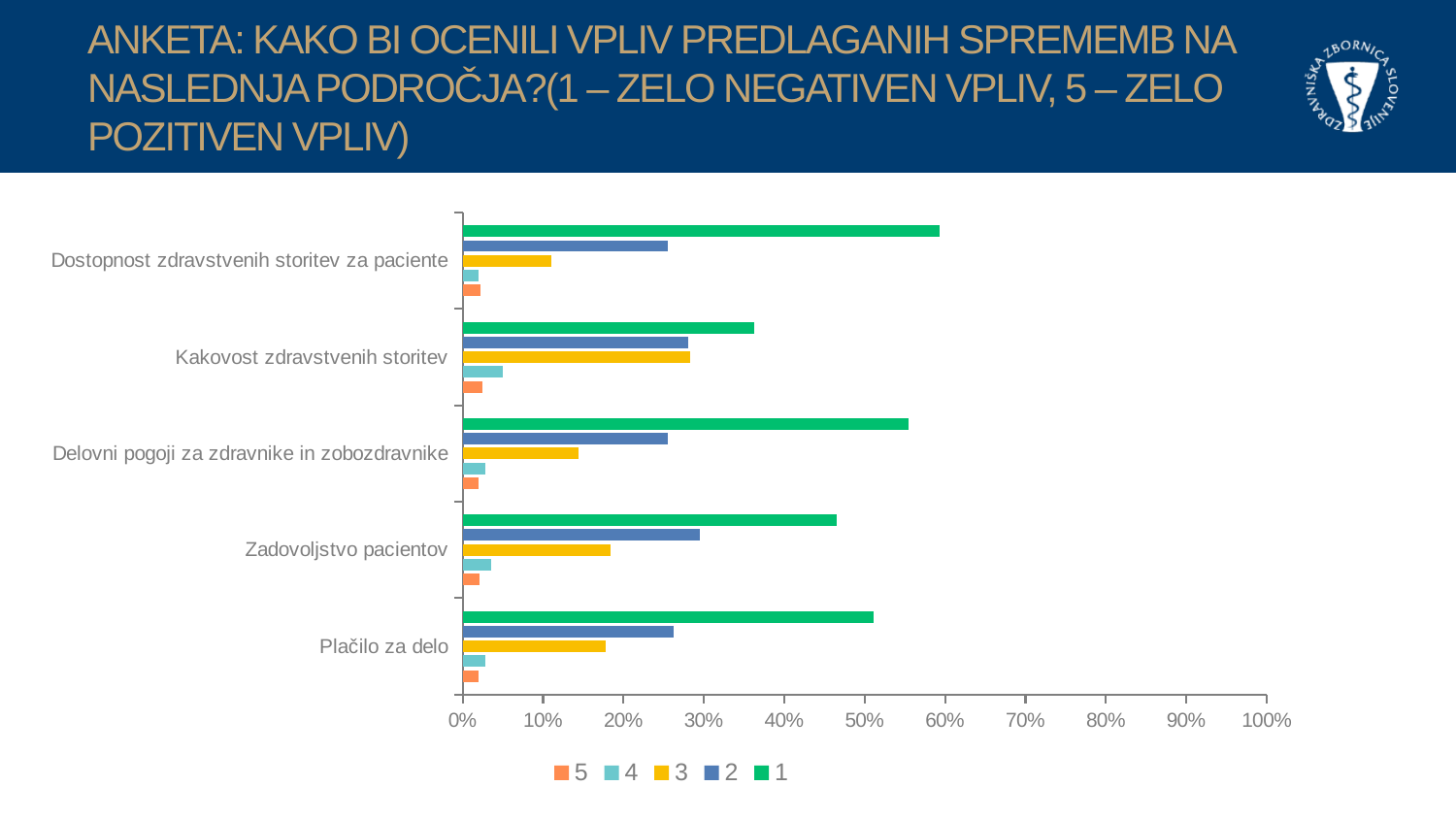
How many series does the chart legend list? 5 Which category has the shortest bar for series 1? Kakovost zdravstvenih storitev How many categories (areas) are listed on the vertical axis of the chart? 5 Which series is shown in orange in the chart legend? 5 What kind of chart is shown on the slide? bar chart Is the value of series 1 for Kakovost zdravstvenih storitev greater or less than 40%? less Which series is shown in green in the chart legend? 1 Which category has the longest bar for series 1? Dostopnost zdravstvenih storitev za paciente Is the value of series 1 for Dostopnost zdravstvenih storitev za paciente greater or less than 50%? greater For Zadovoljstvo pacientov, which series has the larger value: series 2 or series 3? series 2 Is the value of series 3 for Dostopnost zdravstvenih storitev za paciente greater or less than 20%? less